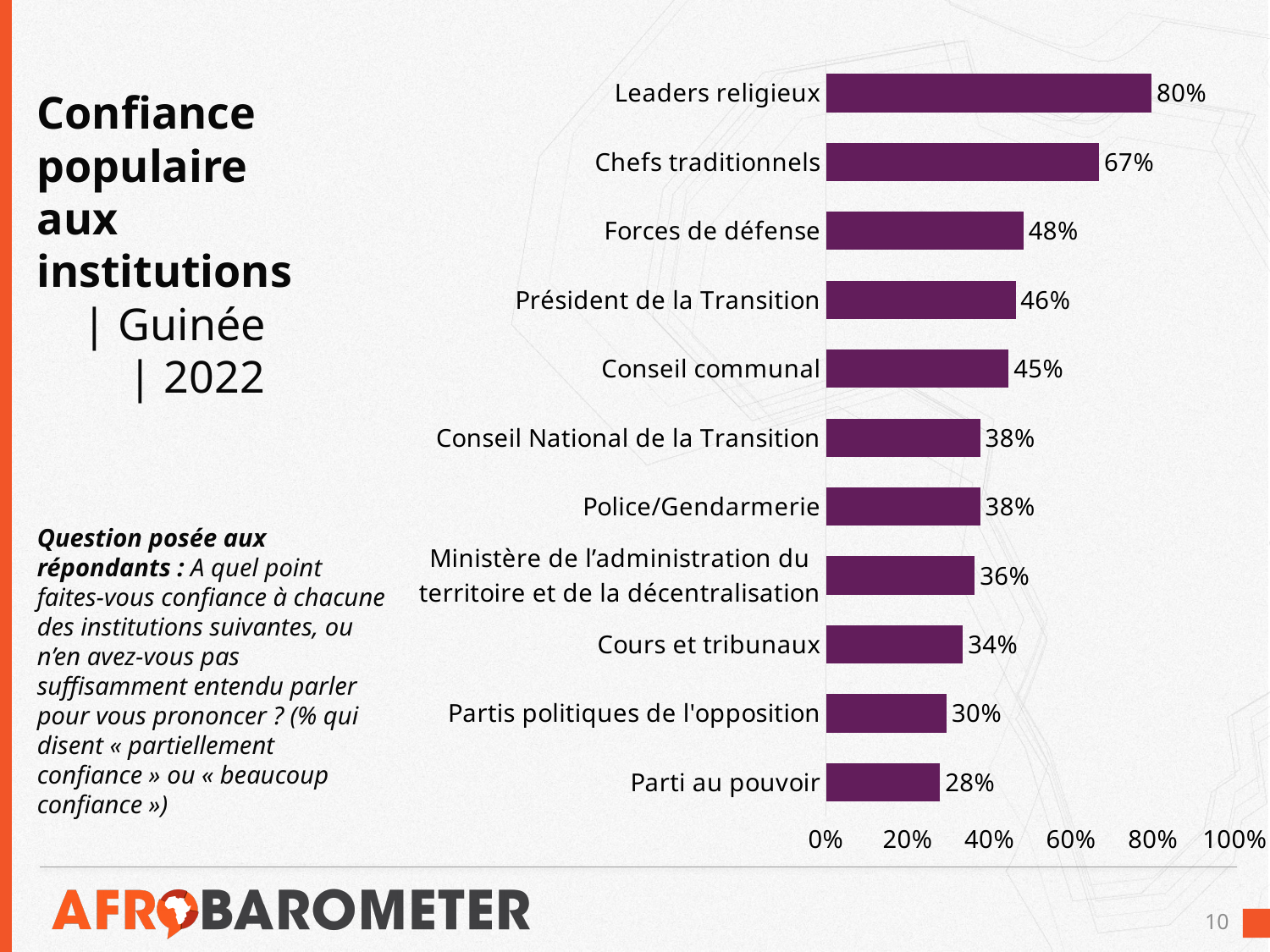
Which has a higher value, Président de la Transition or Conseil communal? Président de la Transition What is the value shown for Forces de défense? 48% What is the value shown for Cours et tribunaux? 34% What is the difference between the values for Leaders religieux and Chefs traditionnels? 13% What percentage of respondents express trust in Leaders religieux? 80% What kind of chart is shown on the slide? Bar chart How many institutions are shown in the chart? 11 What is the value shown for Parti au pouvoir? 28% What is the difference between the values for Partis politiques de l'opposition and Parti au pouvoir? 2% Which institution has the highest level of trust? Leaders religieux What is the value shown for Police/Gendarmerie? 38% Which institution has the lowest level of trust? Parti au pouvoir